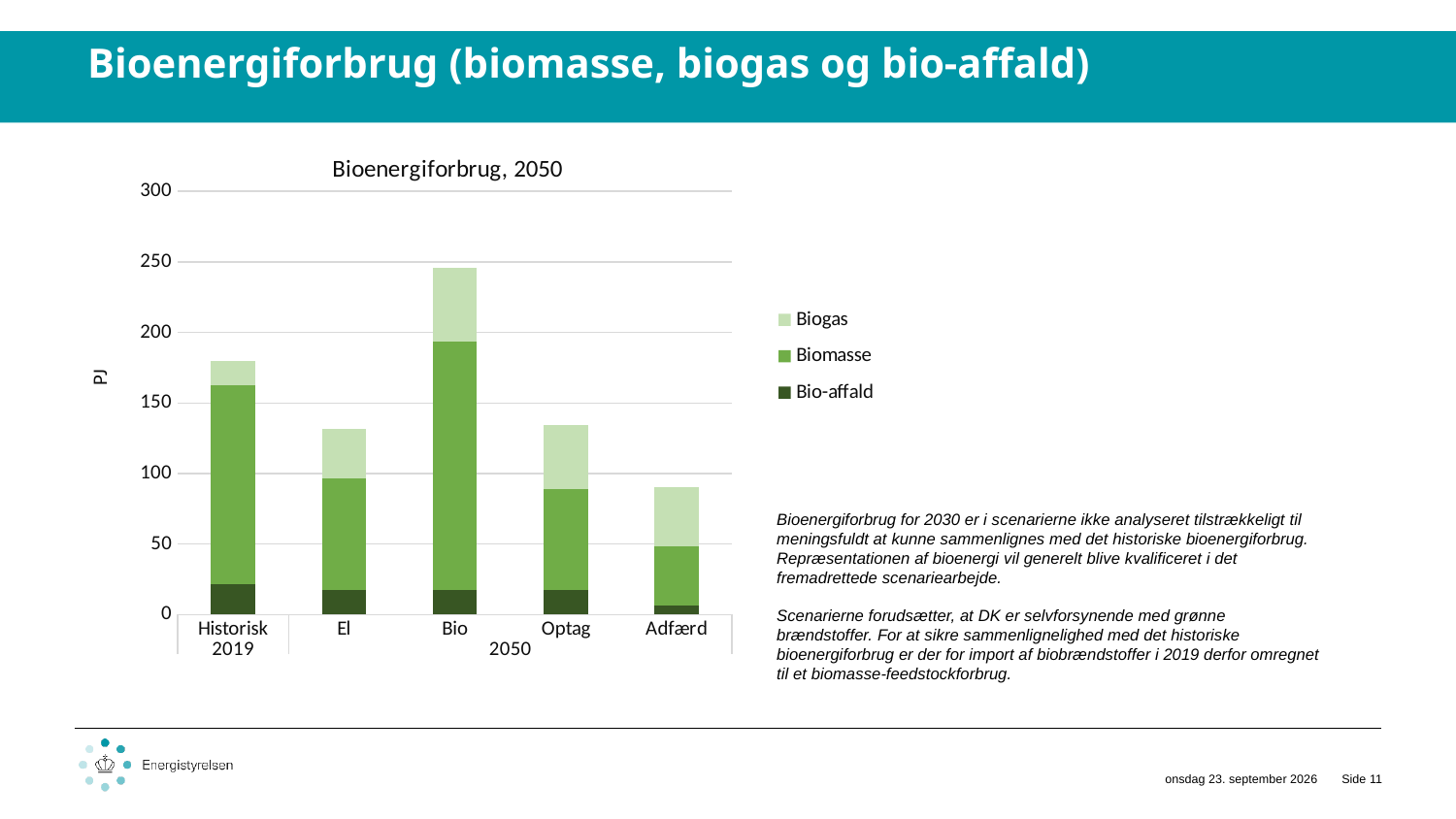
Is the total value for Adfærd greater or less than 100? less What unit is shown on the y axis of the chart? PJ Which has the larger total bar, Historisk 2019 or El? Historisk 2019 Which category has the shortest stacked bar? Adfærd Is the total value for Bio greater or less than 250? less What kind of chart is shown on the slide? Stacked bar chart What is the title of the chart? Bioenergiforbrug, 2050 Which category has the tallest stacked bar? Bio How many series does the legend list? 3 How many categories are shown along the x axis of the chart? 5 Is the total value for El greater or less than 100? greater